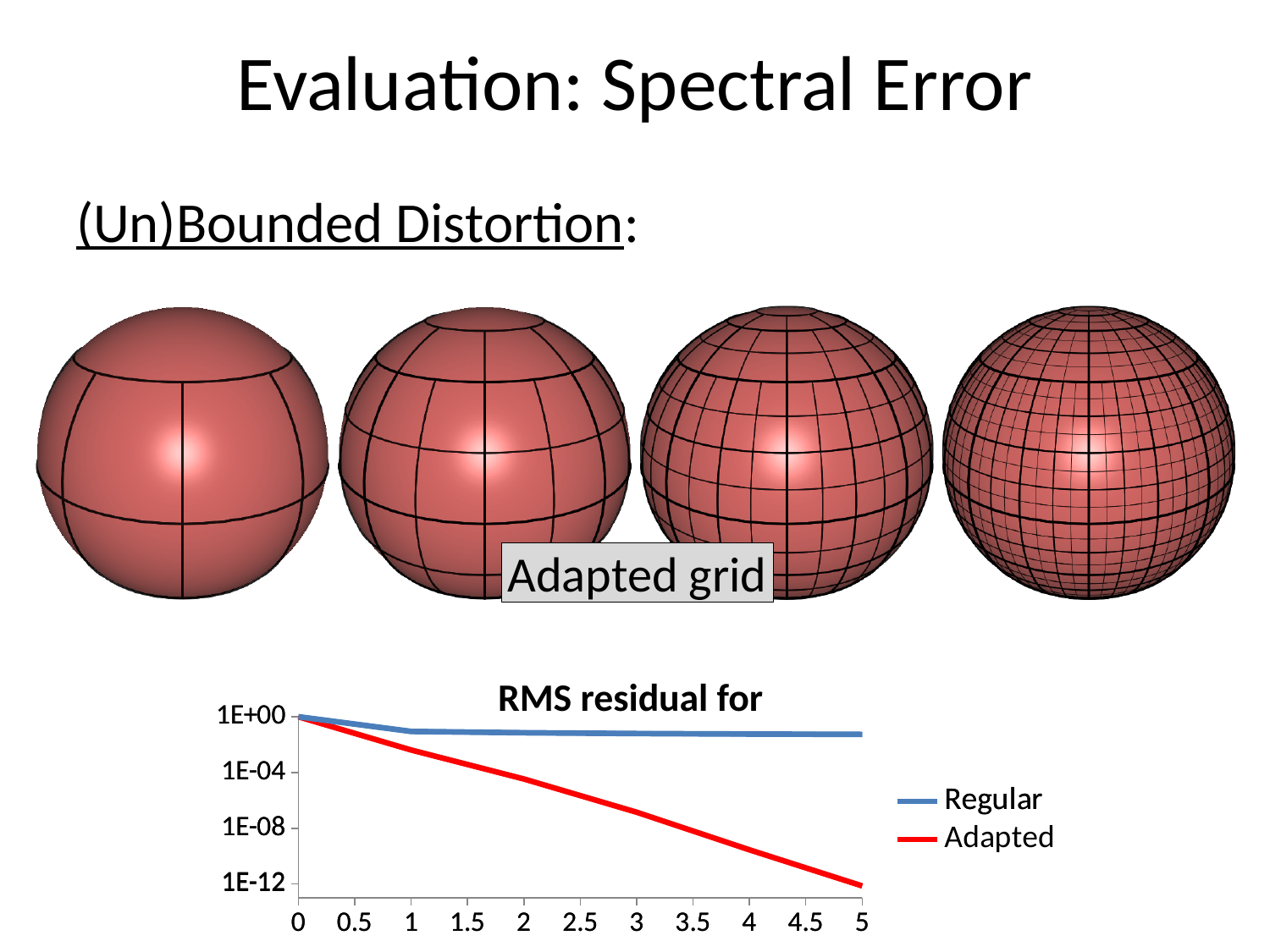
Is the value of the Adapted series at x = 3 greater or less than 1E-04? less What kind of chart is shown on the slide? line chart What are the names of the two series in the chart's legend? Regular and Adapted Is the value of the Regular series at x = 5 greater or less than 1E-04? greater Which series shows the steeper decrease across the x axis? Adapted How many tick labels are shown on the chart's x axis? 11 Which series has the higher value at x = 3, Regular or Adapted? Regular Which series has the lower value at x = 5, Regular or Adapted? Adapted How many series does the chart's legend list? 2 Does the Adapted series rise or fall as x increases from 0 to 5? fall What colour is the Adapted series line in the chart? red Is the value of the Adapted series at x = 5 greater or less than 1E-08? less